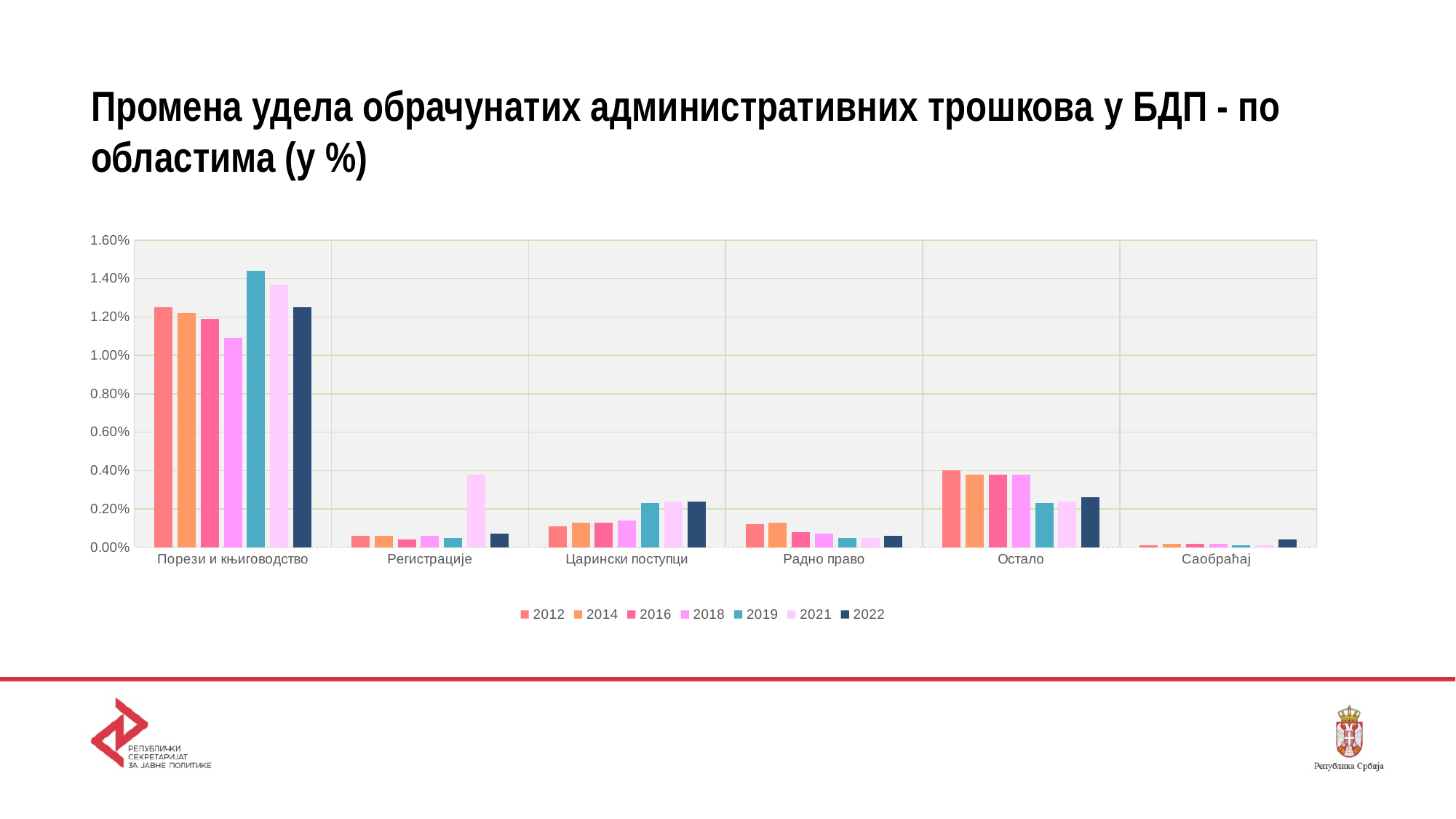
Within the category Порези и књиговодство, which year has the highest value? 2019 How many categories are shown on the x axis of the chart? 6 Which category has the lowest bars overall in the chart? Саобраћај In the category Царински поступци, which is larger: the value for 2012 or the value for 2019? 2019 Within the category Порези и књиговодство, which year has the lowest value? 2018 Is the value for 2019 in Порези и књиговодство greater or less than 1.20%? greater Is the value for 2021 in Регистрације greater or less than 0.20%? greater How many series does the legend list? 7 Is the value for 2018 in Порези и књиговодство greater or less than 1.20%? less Which category has the highest bars overall in the chart? Порези и књиговодство What kind of chart is shown on the slide? bar chart In the category Регистрације, which is larger: the value for 2012 or the value for 2021? 2021